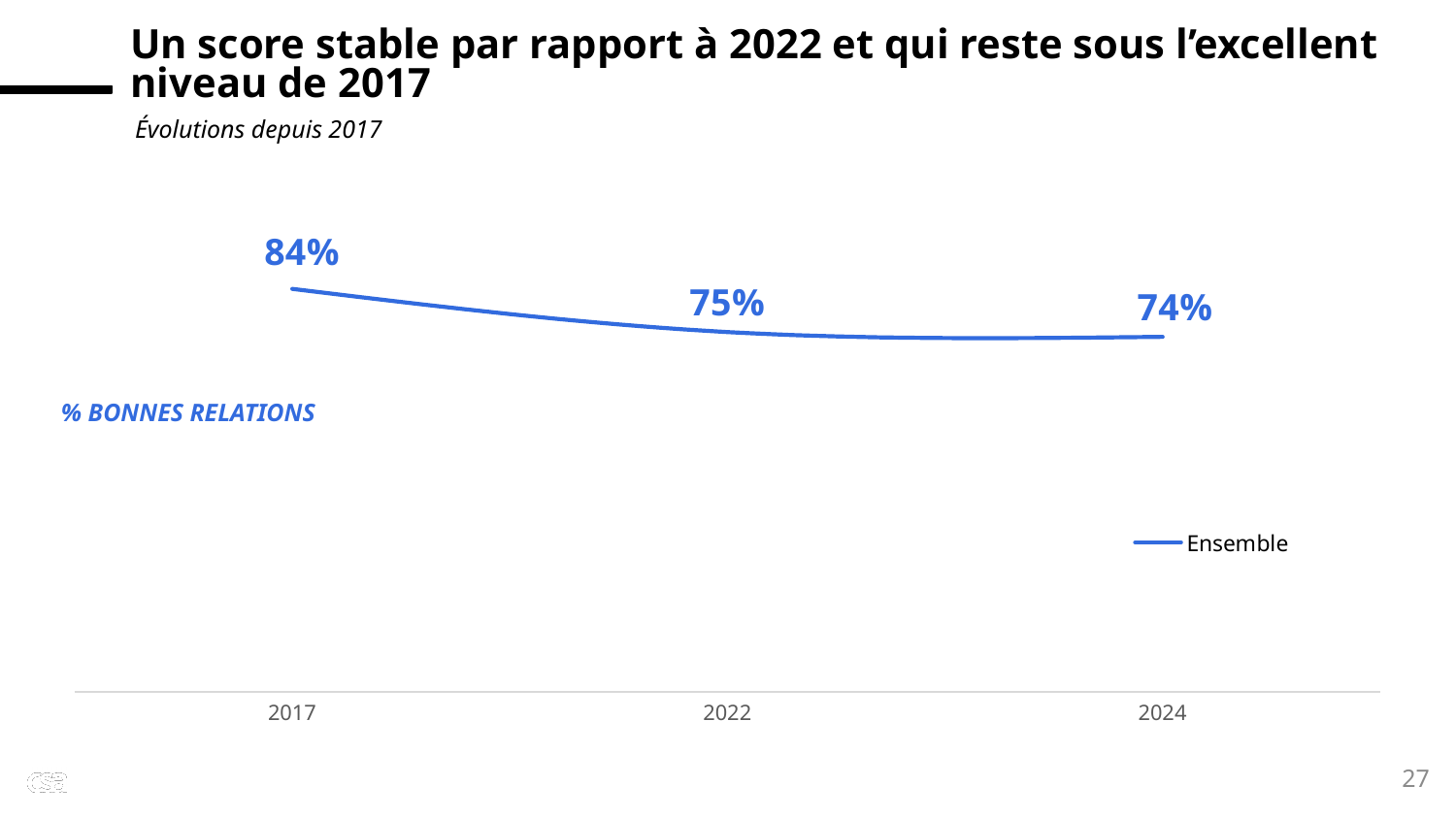
What is the value for 2024? 74% How many series does the legend list? 1 What is the difference between the 2017 value and the 2024 value? 10% Do the values rise or fall from 2017 to 2024? fall What is the difference between the 2022 value and the 2024 value? 1% What is the value for 2017? 84% What kind of chart is shown? line chart What is the value for 2022? 75% How many years are plotted on the chart? 3 Which is larger, the value for 2017 or the value for 2022? 2017 Which year has the highest value? 2017 Which year has the lowest value? 2024